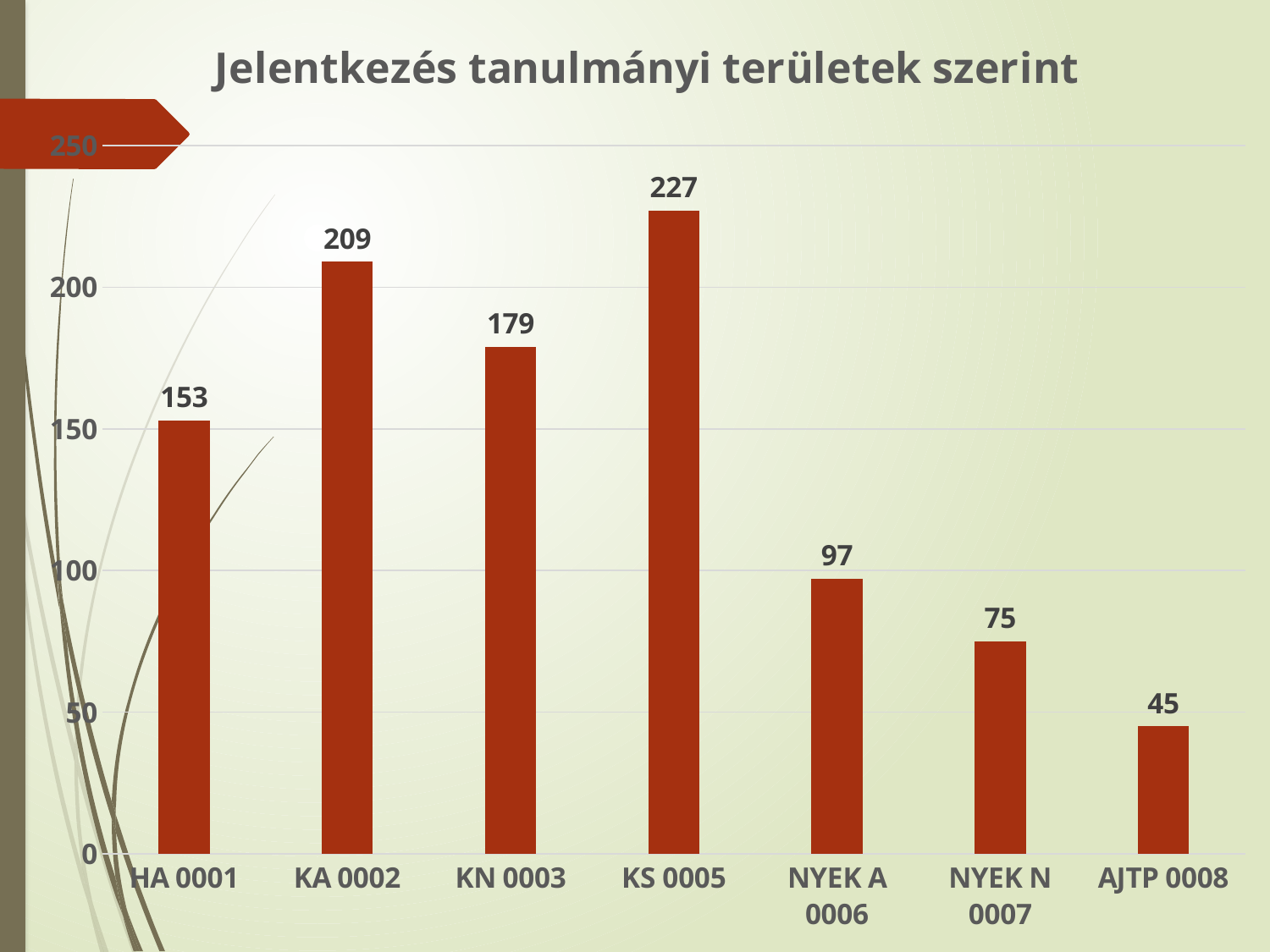
What kind of chart is shown on the slide? bar chart What is the value for NYEK A 0006? 97 Is the value for NYEK N 0007 greater or less than 100? less Which is larger, the value for HA 0001 or the value for KN 0003? KN 0003 What is the difference between the values for HA 0001 and NYEK N 0007? 78 What is the title of the chart? Jelentkezés tanulmányi területek szerint Which category has the highest value? KS 0005 How many categories are shown on the x axis? 7 What is the value for AJTP 0008? 45 What is the value for KA 0002? 209 What is the difference between the values for KS 0005 and KN 0003? 48 Which category has the lowest value? AJTP 0008